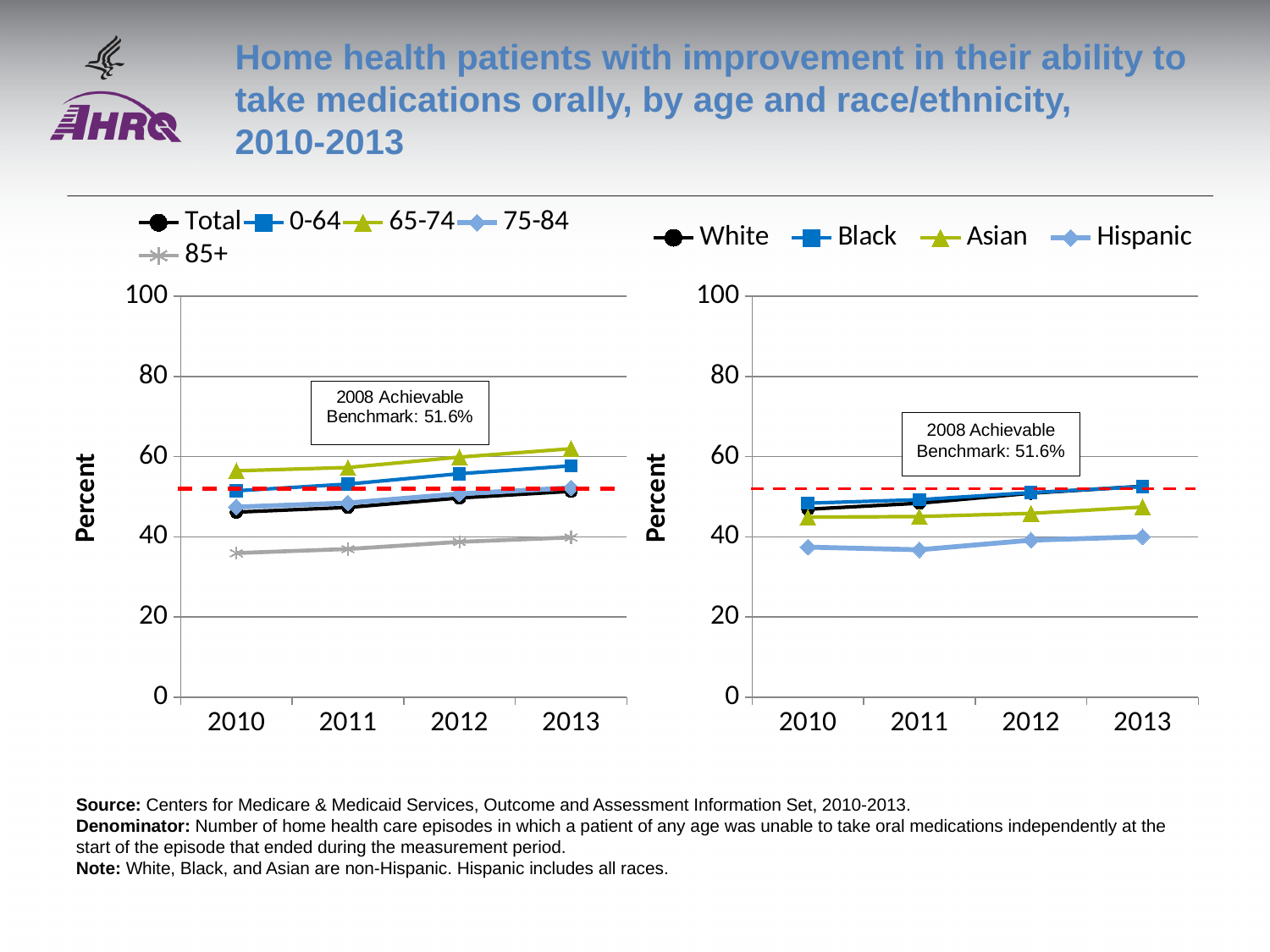
In the right chart (by race/ethnicity), which group has the lowest values across all years? Hispanic In the left chart (by age), is the value for 65-74 in 2013 greater or less than 60? greater In the right chart (by race/ethnicity), which is larger in 2013, the value for Black or the value for Asian? Black In the left chart (by age), is the value for 85+ in 2010 greater or less than 40? less In the left chart (by age), which age group has the lowest values across all years? 85+ How many series does the legend of the right chart (by race/ethnicity) list? 4 How many years are shown on the x axis of the right chart (by race/ethnicity)? 4 How many series does the legend of the left chart (by age) list? 5 In the left chart (by age), which age group has the highest values across all years? 65-74 In the right chart (by race/ethnicity), is the value for Hispanic in 2010 greater or less than 40? less What type of chart is the left chart (by age)? line chart What is the 2008 Achievable Benchmark shown on the charts? 51.6%